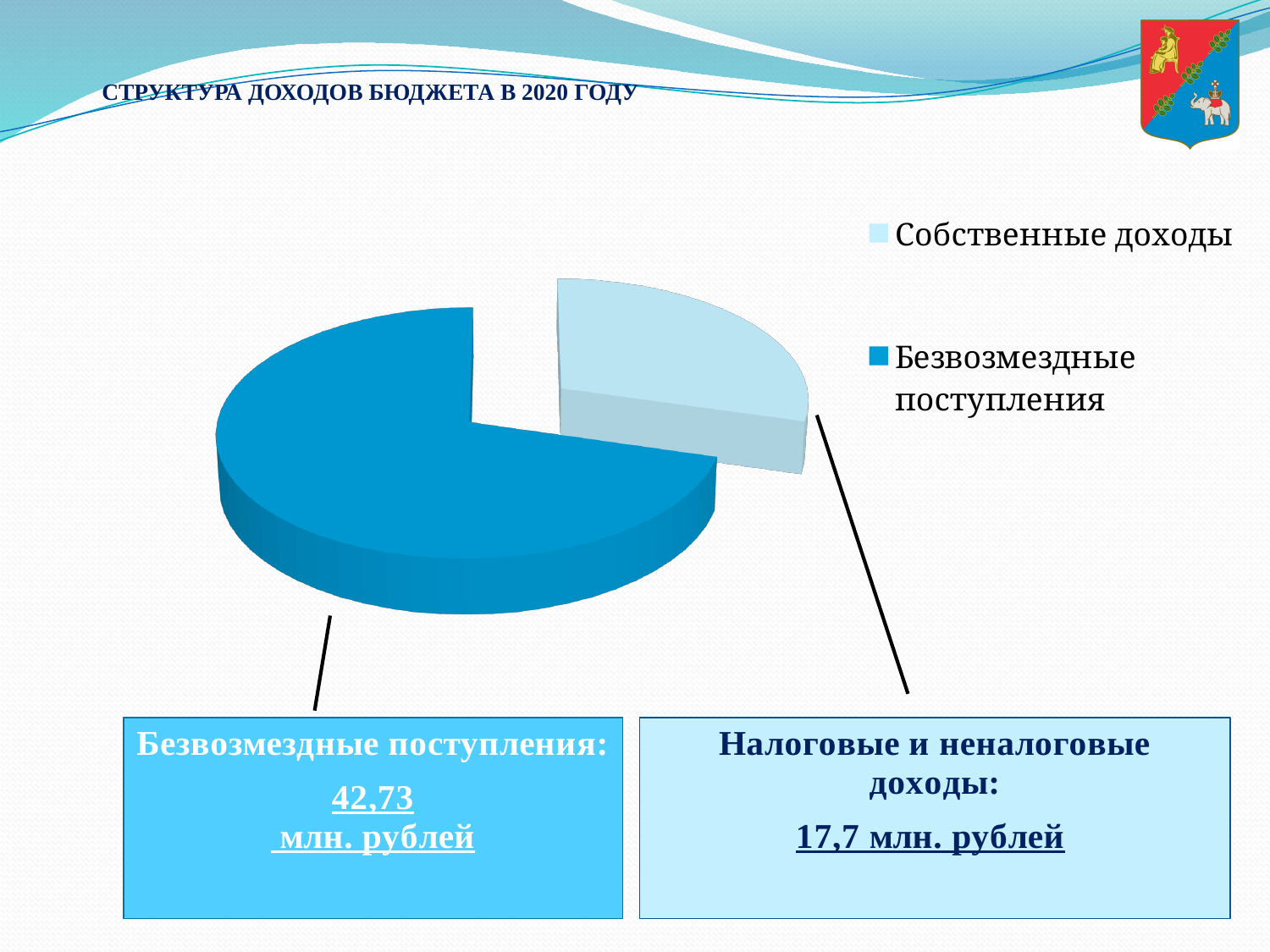
Which slice of the pie is the largest? Безвозмездные поступления What kind of chart is shown on the slide? Pie chart How many entries does the legend list? 2 Which is larger: Безвозмездные поступления or Налоговые и неналоговые доходы? Безвозмездные поступления What is the difference between Безвозмездные поступления (42,73 млн. рублей) and Налоговые и неналоговые доходы (17,7 млн. рублей)? 25,03 млн. рублей Which slice of the pie is the smallest? Собственные доходы How many slices does the pie chart have? 2 What is the title of the slide? СТРУКТУРА ДОХОДОВ БЮДЖЕТА В 2020 ГОДУ What is the value shown for Налоговые и неналоговые доходы? 17,7 млн. рублей What is the value shown for Безвозмездные поступления? 42,73 млн. рублей What is the total of the two values shown, 42,73 and 17,7 млн. рублей? 60,43 млн. рублей Which legend entry is shown in the lighter blue colour? Собственные доходы